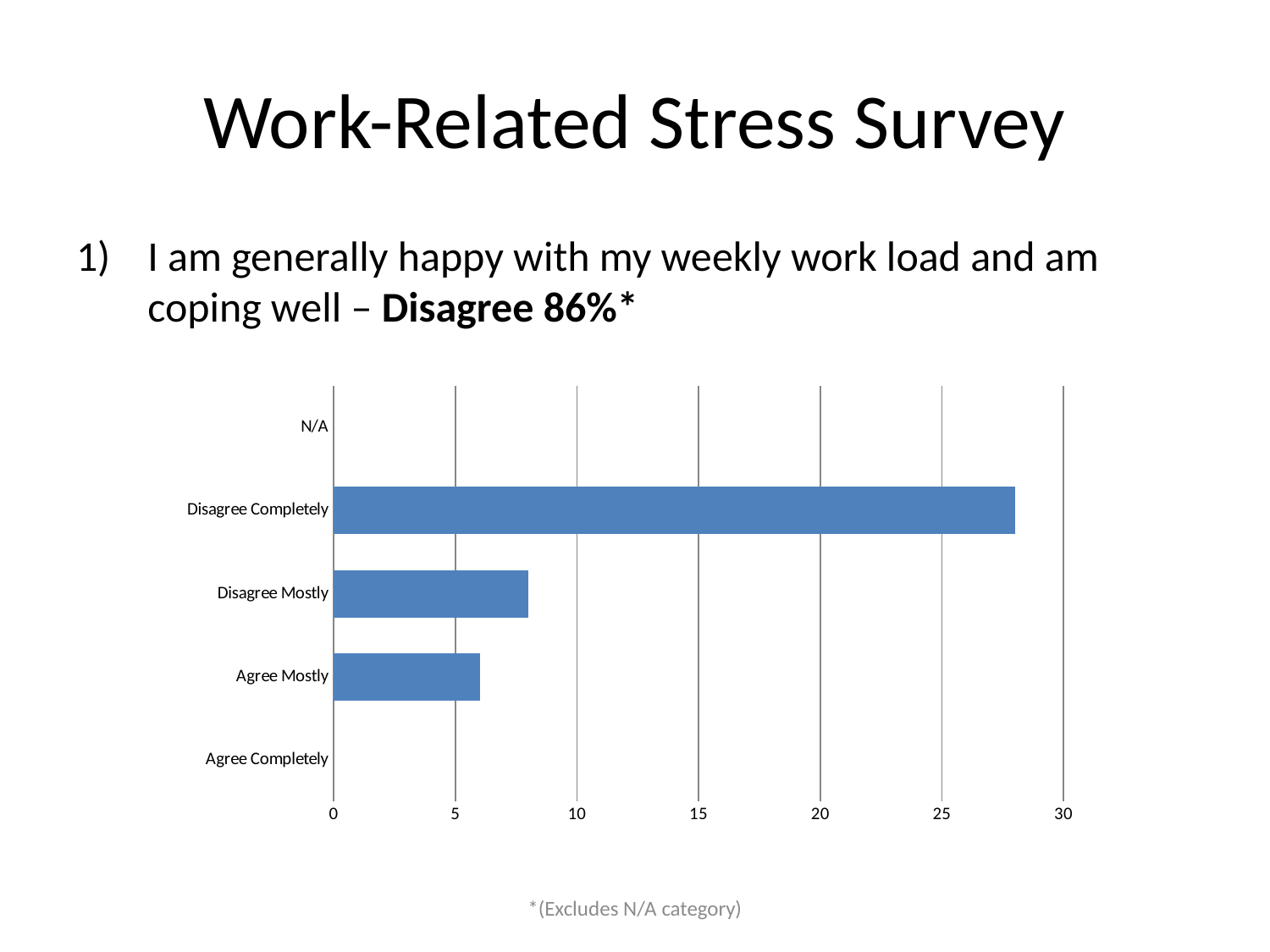
Which is larger, the value for Disagree Completely or the value for Disagree Mostly? Disagree Completely How many categories are shown on the chart's vertical axis? 5 Which category is listed at the top of the chart's vertical axis? N/A Is the value for Disagree Mostly greater or less than 10? less Is the value for Agree Mostly greater or less than 10? less Which is larger, the value for Disagree Mostly or the value for Agree Mostly? Disagree Mostly What is the highest value shown on the chart's horizontal axis? 30 Is the value for Disagree Mostly greater or less than 5? greater Which category has the highest value in the chart? Disagree Completely What kind of chart is shown on the slide? bar chart